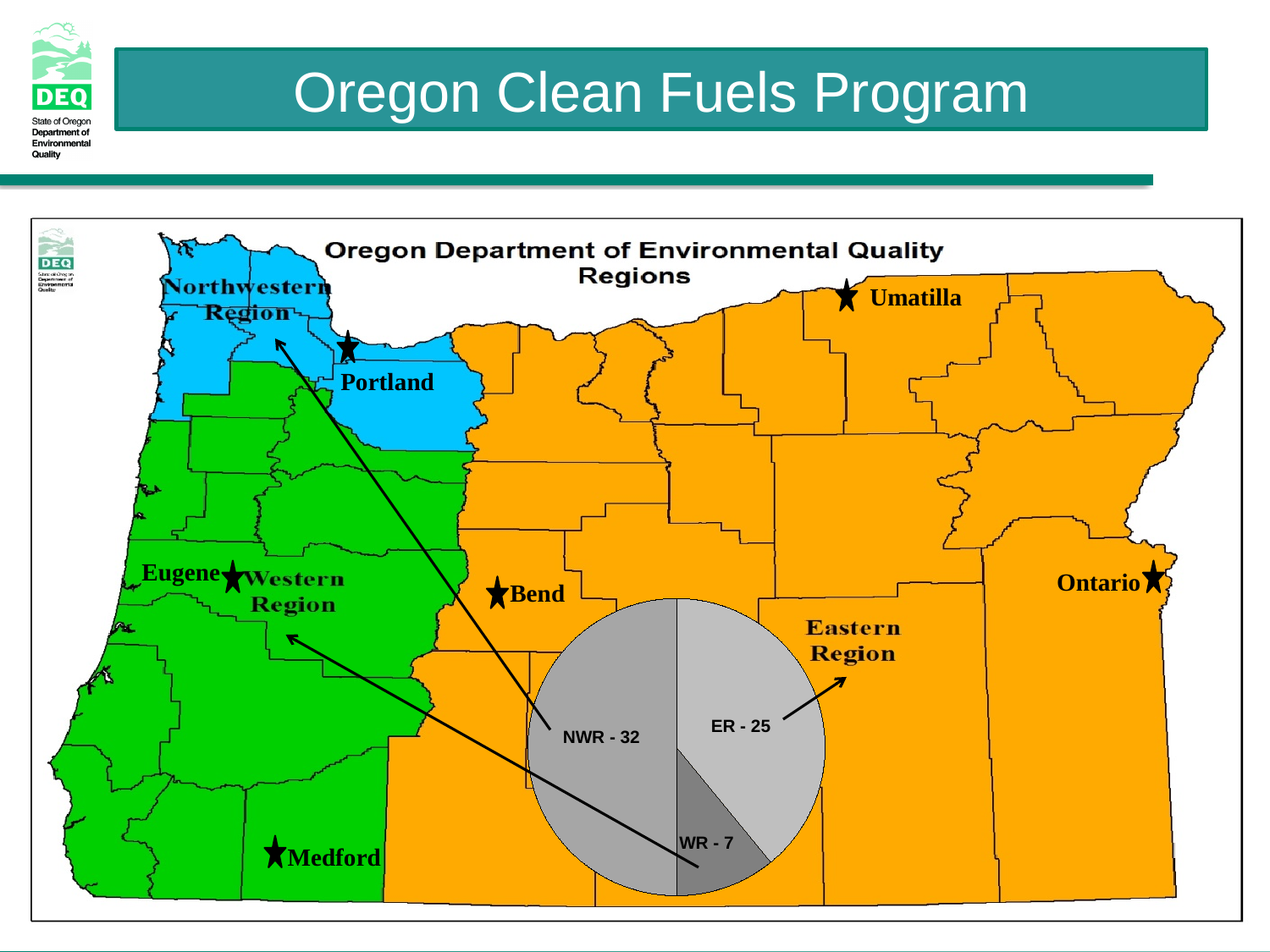
What share of the pie chart does the NWR slice represent? 50% What is the value for WR in the pie chart? 7 What is the total of all slices in the pie chart? 64 What is the difference between the ER and WR values in the pie chart? 18 Which slice of the pie chart has the highest value? NWR What is the difference between the NWR and ER values in the pie chart? 7 How many slices does the pie chart have? 3 What is the value for NWR in the pie chart? 32 What kind of chart is overlaid on the map? pie chart Which slice of the pie chart has the lowest value? WR What is the value for ER in the pie chart? 25 Which is larger in the pie chart, ER or WR? ER